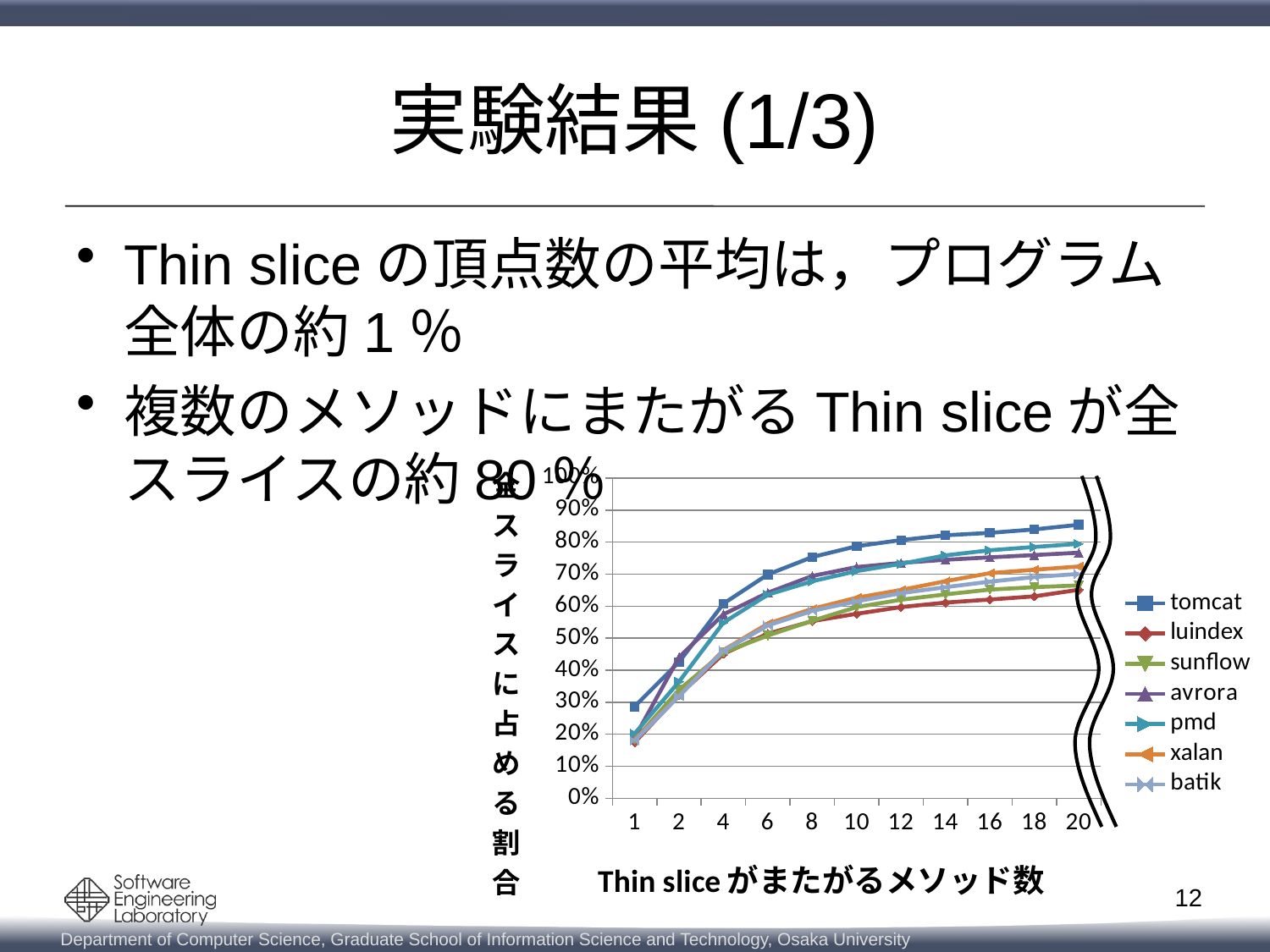
Do the values for tomcat rise or fall as the number of methods on the x axis increases? rise Which series has the highest value at x = 20? tomcat At x = 20, which is larger, the value for tomcat or the value for luindex? tomcat Is the value for luindex at x = 20 greater or less than 70%? less Is the value for sunflow at x = 4 greater or less than 50%? less Is the value for tomcat at x = 1 greater or less than 20%? greater How many values are labelled on the x axis of the chart? 11 What is the title of the x axis of the chart? Thin slice がまたがるメソッド数 Which series has the highest value at x = 1? tomcat How many series does the chart's legend list? 7 What kind of chart is shown on the slide? line chart